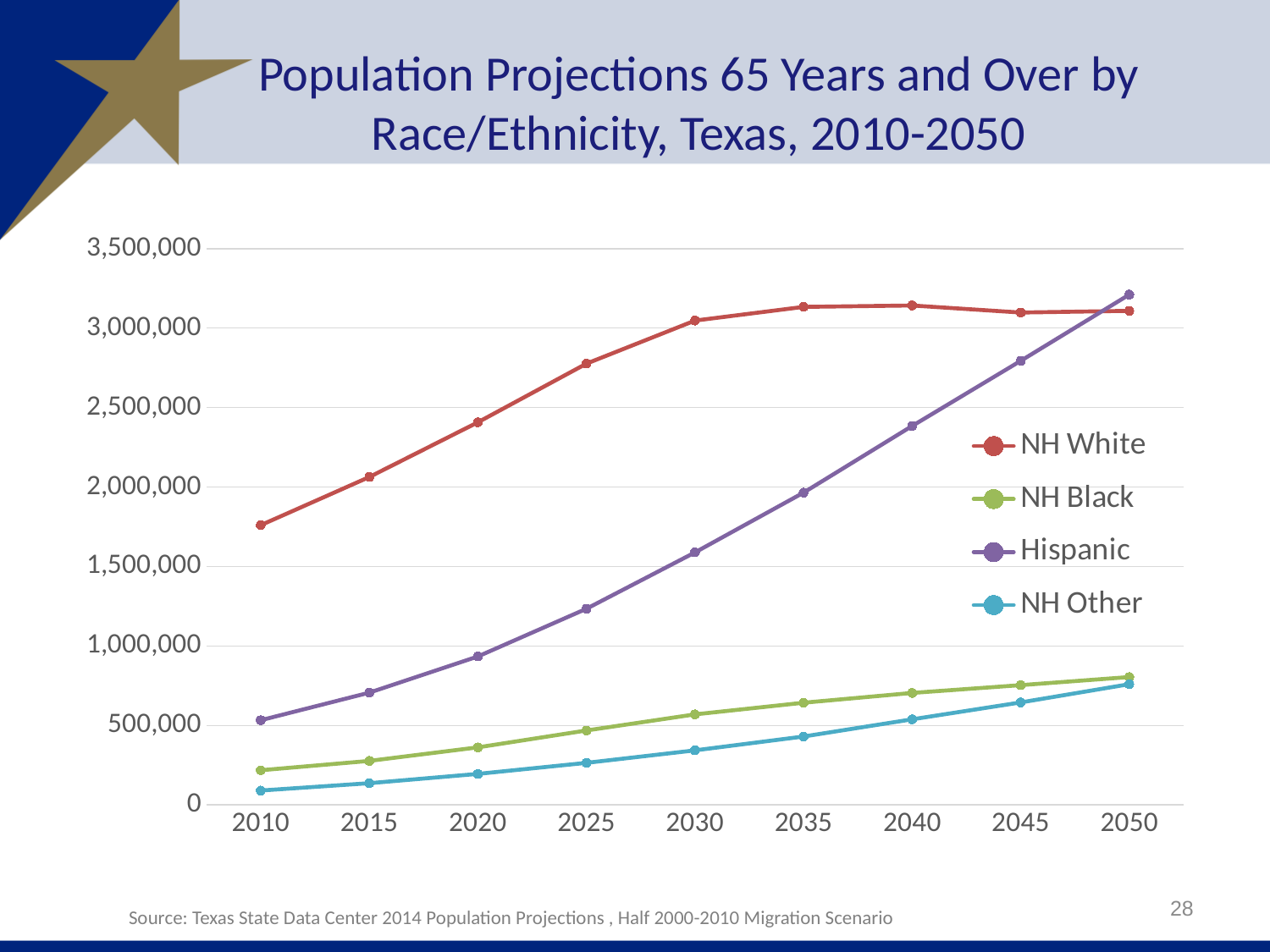
Which series has the lowest value in 2010? NH Other What kind of chart is shown on the slide? line chart What is the title of the chart? Population Projections 65 Years and Over by Race/Ethnicity, Texas, 2010-2050 Which series has the highest value in 2050? Hispanic Is the value for Hispanic in 2030 greater or less than 2,000,000? less Is the value for NH Black in 2050 greater or less than 1,000,000? less Does the Hispanic series rise or fall from 2010 to 2050? rise Which series has the highest value in 2010? NH White Is the value for NH White in 2010 greater or less than 1,500,000? greater How many series does the legend list? 4 In 2040, which is larger: NH White or Hispanic? NH White How many years are shown along the x axis? 9